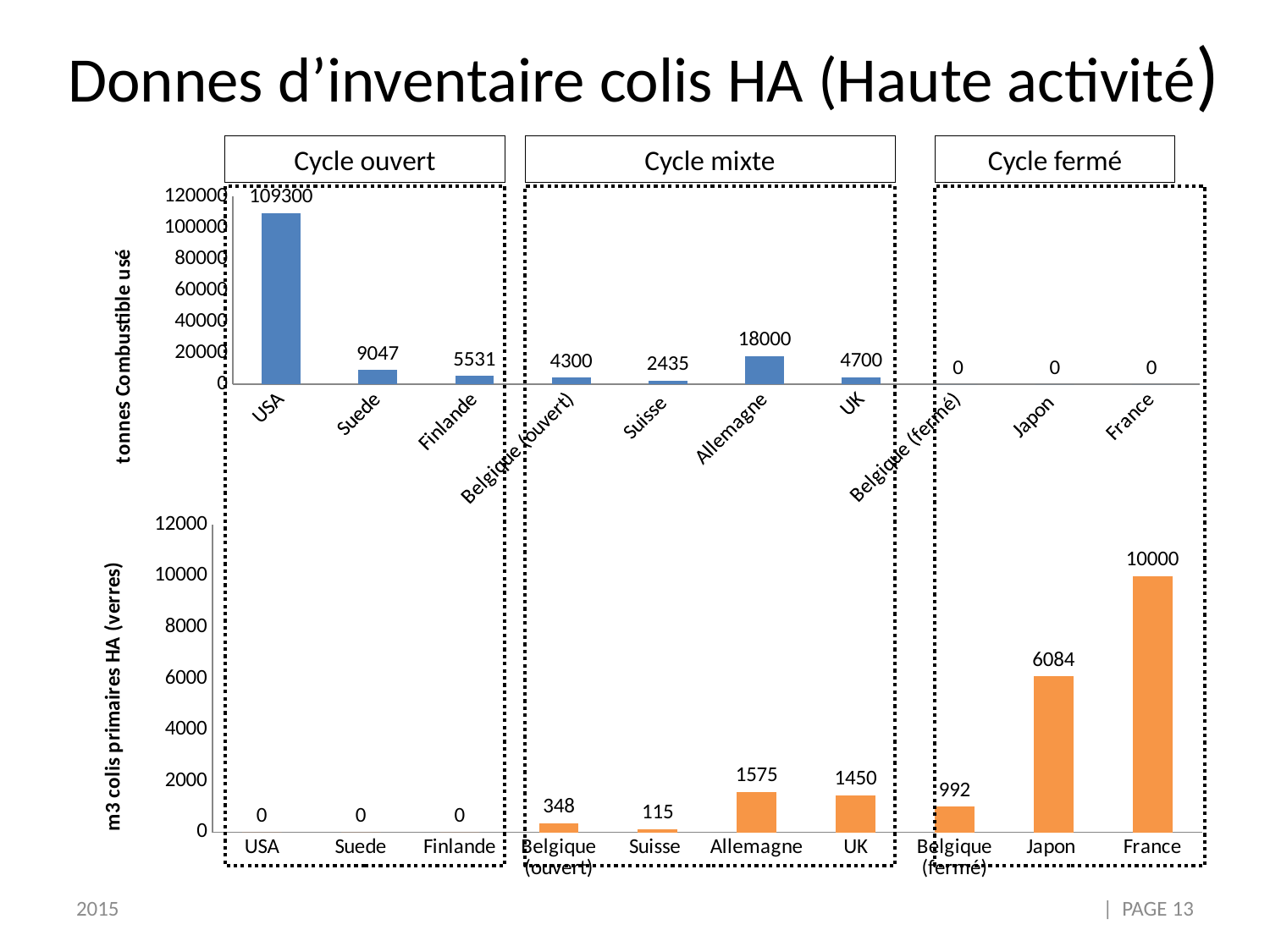
In the bottom chart (m3 colis primaires HA (verres)), which country has the highest value? France In the bottom chart (m3 colis primaires HA (verres)), what is the value for Suisse? 115 In the top chart (tonnes Combustible usé), which is larger, Belgique (ouvert) or UK? UK In the bottom chart (m3 colis primaires HA (verres)), what is the difference between Allemagne and UK? 125 In the top chart (tonnes Combustible usé), which country has the highest value? USA In the top chart (tonnes Combustible usé), what is the value for USA? 109300 In the top chart (tonnes Combustible usé), what is the difference between Suede and Finlande? 3516 In the top chart (tonnes Combustible usé), what is the value for Allemagne? 18000 In the bottom chart (m3 colis primaires HA (verres)), is the value for Japon greater or less than 4000? greater In the bottom chart (m3 colis primaires HA (verres)), what is the value for Japon? 6084 What type of chart is the top chart (tonnes Combustible usé)? bar chart How many countries are shown on the x axis of the bottom chart (m3 colis primaires HA (verres))? 10